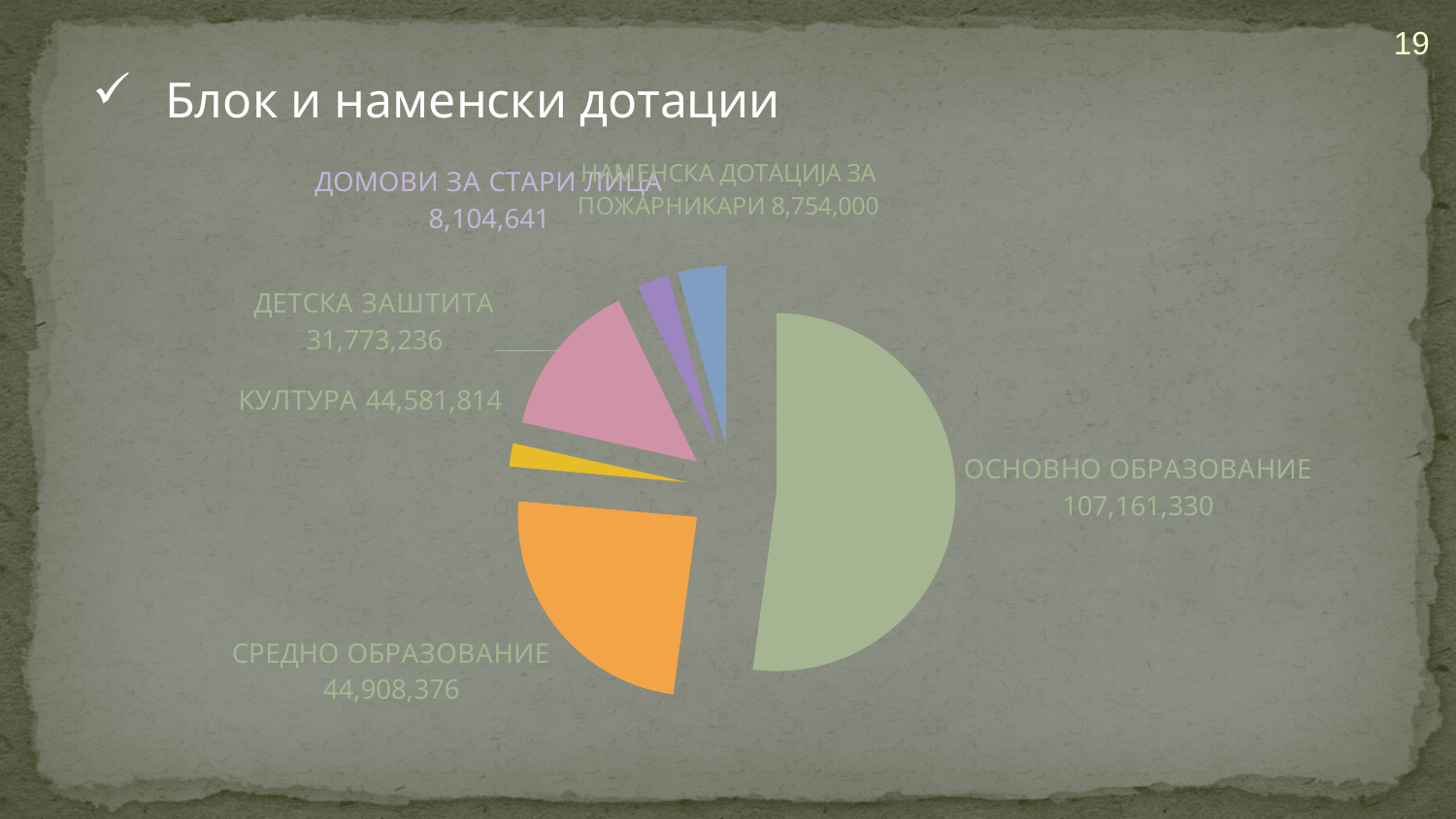
Which is larger, the value for КУЛТУРА or the value for ДЕТСКА ЗАШТИТА? КУЛТУРА Which category has the highest value? ОСНОВНО ОБРАЗОВАНИЕ What is the value for ОСНОВНО ОБРАЗОВАНИЕ? 107,161,330 What is the value for ДОМОВИ ЗА СТАРИ ЛИЦА? 8,104,641 Which category has the lowest value? ДОМОВИ ЗА СТАРИ ЛИЦА What is the value for НАМЕНСКА ДОТАЦИЈА ЗА ПОЖАРНИКАРИ? 8,754,000 What is the value for СРЕДНО ОБРАЗОВАНИЕ? 44,908,376 What is the value for ДЕТСКА ЗАШТИТА? 31,773,236 What kind of chart is shown on the slide? pie chart What is the title of the slide above the chart? Блок и наменски дотации How many categories are shown in the pie chart? 6 What is the difference between the values for ОСНОВНО ОБРАЗОВАНИЕ and СРЕДНО ОБРАЗОВАНИЕ? 62,252,954